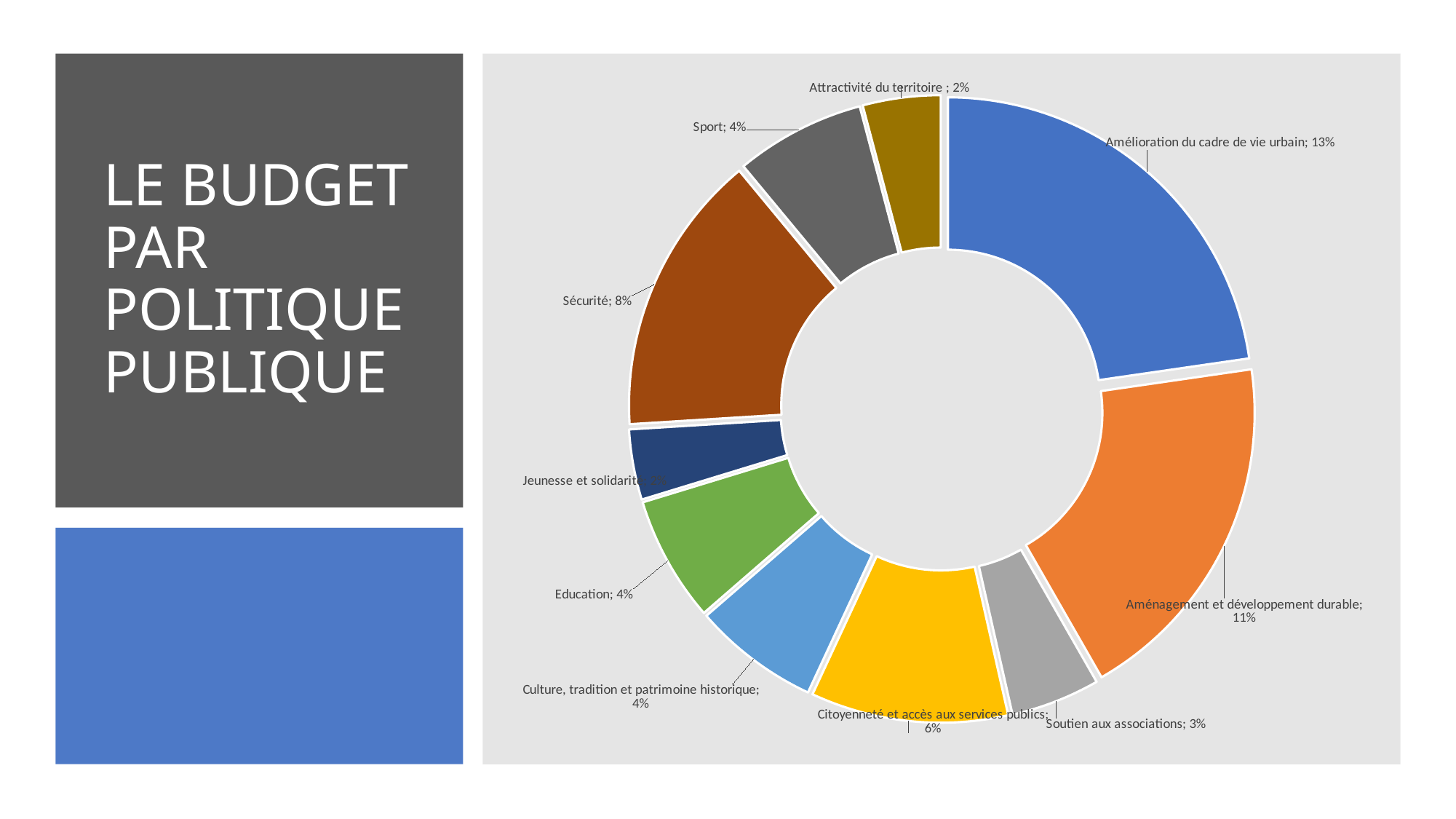
What is the value for Soutien aux associations? 3% What percentage is shown for Citoyenneté et accès aux services publics? 6% What percentage of the budget goes to Amélioration du cadre de vie urbain? 13% What percentage is shown for Attractivité du territoire? 2% What kind of chart is shown on the slide? doughnut chart Which policy area has the largest share of the budget? Amélioration du cadre de vie urbain Which is larger, the share for Sécurité or the share for Sport? Sécurité What is the difference between the shares for Sécurité and Soutien aux associations? 5% What percentage is shown for Aménagement et développement durable? 11% What is the value for Sécurité? 8% What is the difference between the shares for Amélioration du cadre de vie urbain and Aménagement et développement durable? 2% How many policy areas are shown in the chart? 10